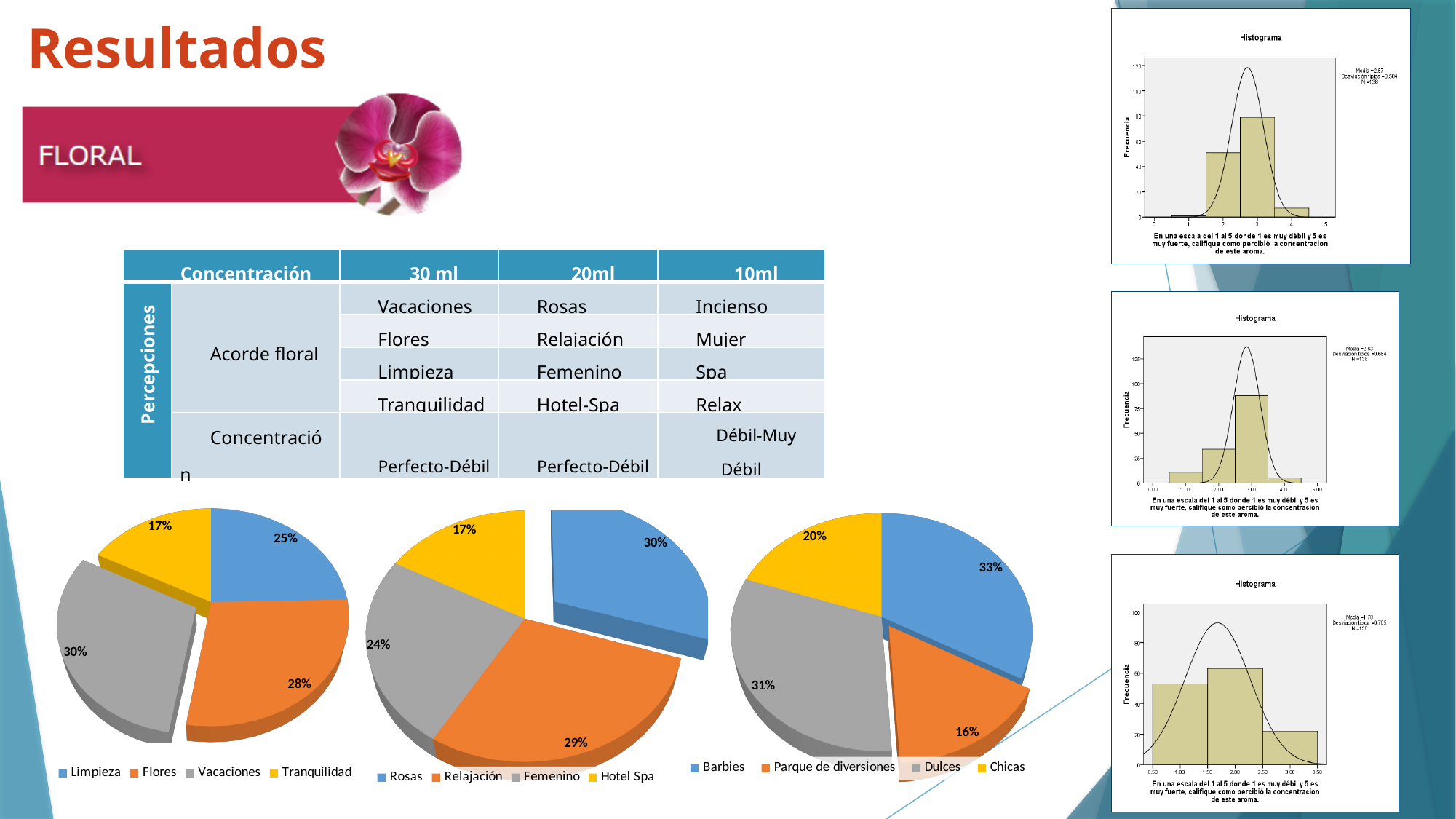
How many categories does the legend of the middle pie chart list? 4 In the left pie chart, which category has the smallest share? Tranquilidad In the middle pie chart, what share does Femenino have? 24% In the middle pie chart, which category has the largest share? Rosas In the left pie chart, what share does Vacaciones have? 30% In the left pie chart, what is the difference between the shares of Flores and Limpieza? 3% In the right pie chart, what share does Parque de diversiones have? 16% What kind of chart is the left-hand chart at the bottom of the slide? pie chart In the middle pie chart, which is larger, Relajación or Hotel Spa? Relajación In the right pie chart, what is the difference between the shares of Dulces and Chicas? 11% In the right pie chart, which category has the largest share? Barbies In the right pie chart, what colour is the Chicas slice? yellow